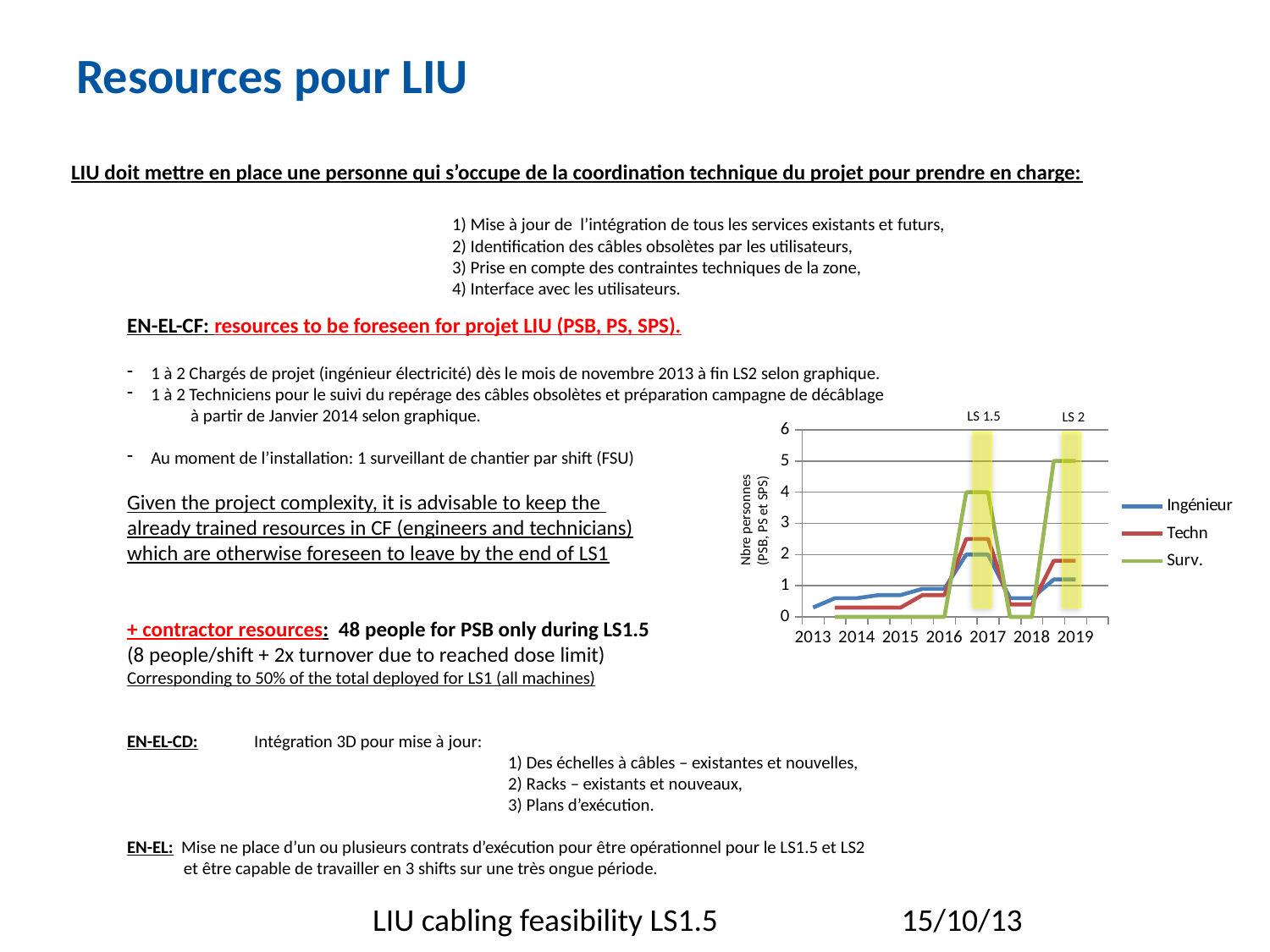
Is the value for Techn in 2019 greater or less than 1? greater What are the three series named in the chart legend? Ingénieur, Techn, Surv. What kind of chart is shown on the slide? line chart Is the value for Ingénieur in 2019 greater or less than 2? less Is the value for Surv. in 2017 greater or less than 3? greater Which series reaches the highest value in 2017? Surv. How many series does the chart legend list? 3 Does the Surv. series rise or fall between 2017 and 2018? fall What is the label of the chart's vertical axis? Nbre personnes (PSB, PS et SPS) Which series has the highest value in 2019? Surv. How many years are labelled on the chart's x axis? 7 In 2019, which is larger: the value for Ingénieur or the value for Surv.? Surv.